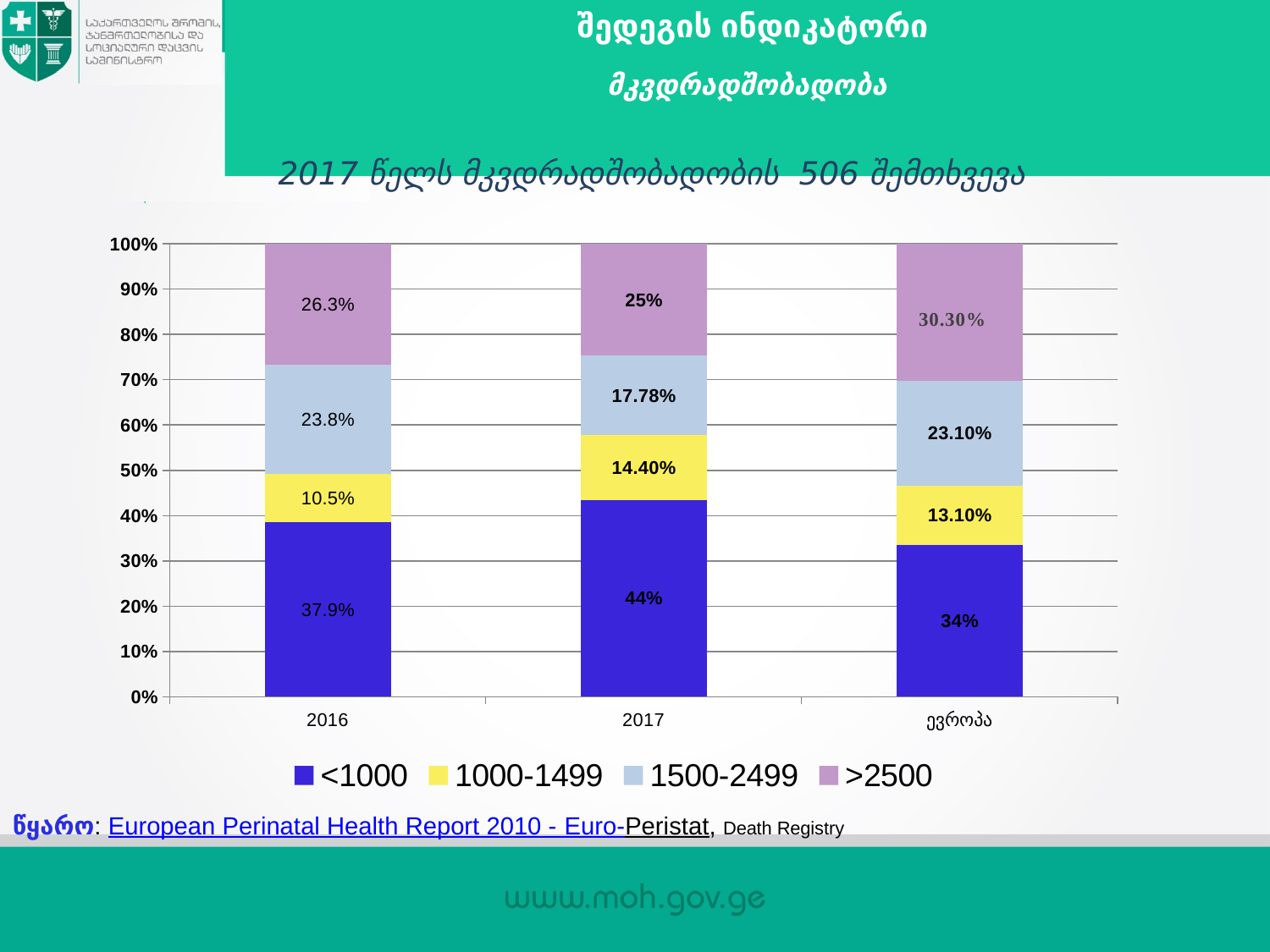
What is the value of the 1000-1499 series for 2017? 14.40% Which series is shown in yellow in the legend? 1000-1499 What is the value of the >2500 series for ევროპა? 30.30% How many series does the legend list? 4 How many categories are shown on the x axis? 3 Which is larger: the >2500 value for 2016 or for 2017? 2016 What is the value of the 1500-2499 series for 2016? 23.8% What is the value of the <1000 series for 2017? 44% What is the difference between the <1000 values for 2017 and 2016? 6.1% Which category has the highest value for the <1000 series? 2017 What kind of chart is shown on the slide? Stacked bar chart Which category has the lowest value for the 1000-1499 series? 2016